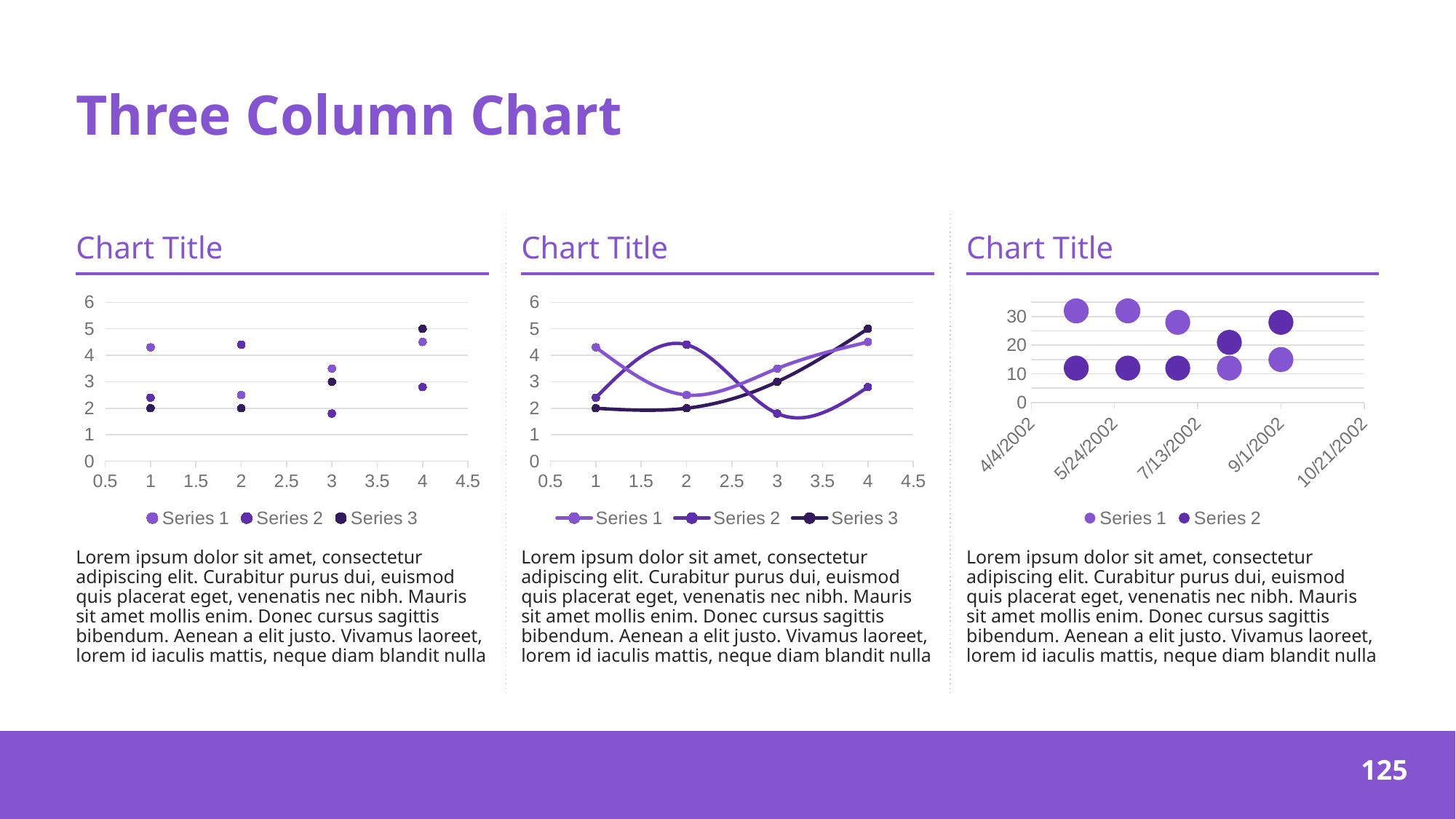
In the left chart, is the Series 1 value at x = 1 greater or less than 4? greater How many series does the legend of the middle chart list? 3 What kind of chart is the right chart? bubble chart What kind of chart is the middle chart? line chart In the left chart, is the Series 3 value at x = 4 greater or less than 4? greater How many series does the legend of the left chart list? 3 In the middle chart, is the Series 2 value at x = 2 greater or less than 4? greater How many series does the legend of the right chart list? 2 In the middle chart, which series has the highest value at x = 4? Series 3 What kind of chart is the left chart? scatter chart In the left chart, how many points does Series 1 have? 4